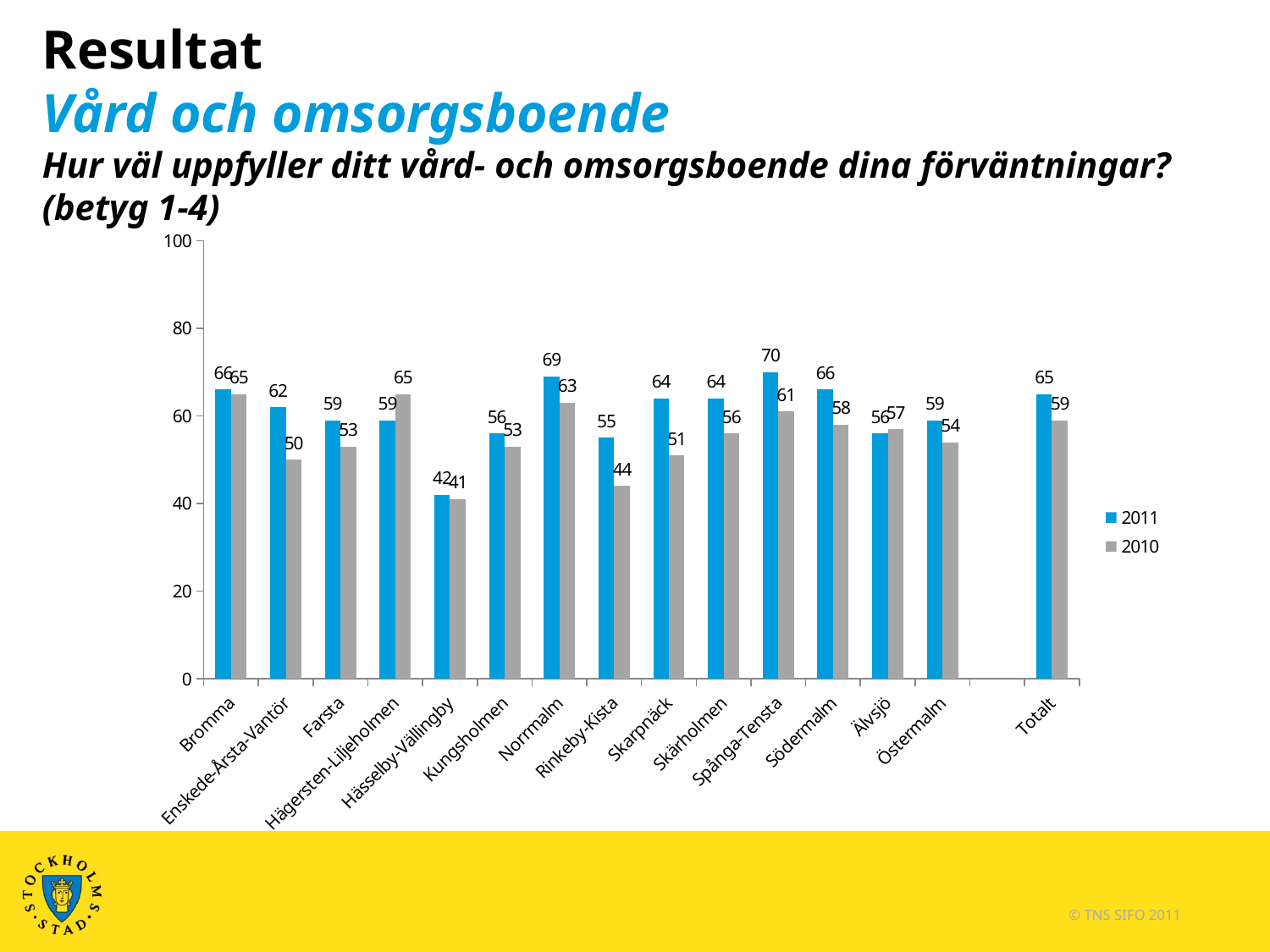
What is the 2010 value for Enskede-Årsta-Vantör? 50 Which category has the highest 2011 value? Spånga-Tensta Which category has the lowest 2010 value? Hässelby-Vällingby How many series does the legend list? 2 What is the 2011 value for Spånga-Tensta? 70 Is the 2011 value for Norrmalm greater or less than 60? greater Which is larger for Hägersten-Liljeholmen, the 2011 value or the 2010 value? 2010 Which colour represents the 2010 series in the legend? grey What is the difference between the 2011 and 2010 values for Rinkeby-Kista? 11 What is the 2011 value for Totalt? 65 How many categories are shown on the x axis? 15 What kind of chart is shown on the slide? bar chart